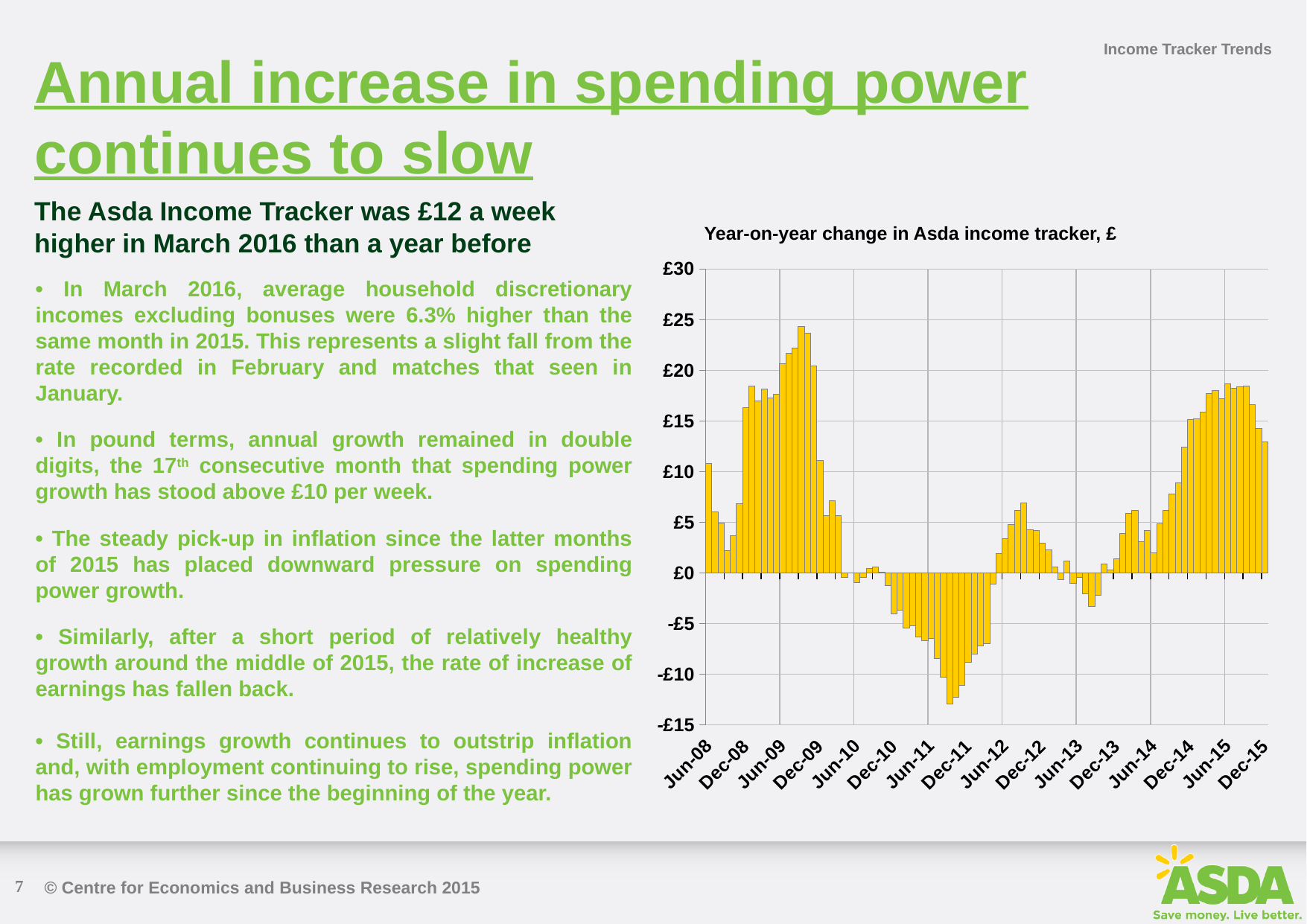
Is the value for Dec-11 greater or less than -£10? greater What is the title of the chart? Year-on-year change in Asda income tracker, £ Do the values rise or fall between Dec-13 and Jun-15? rise In which year does the highest bar in the chart occur? 2009 How many date labels are shown on the x axis of the chart? 16 Is the value for Jun-08 greater or less than £5? greater Which is larger, the value for Jun-09 or the value for Jun-11? Jun-09 Is the value for Jun-15 greater or less than £15? greater What is the highest value shown on the y axis of the chart? £30 Around which x-axis label does the lowest bar in the chart occur? Dec-11 What kind of chart is shown on the slide? bar chart